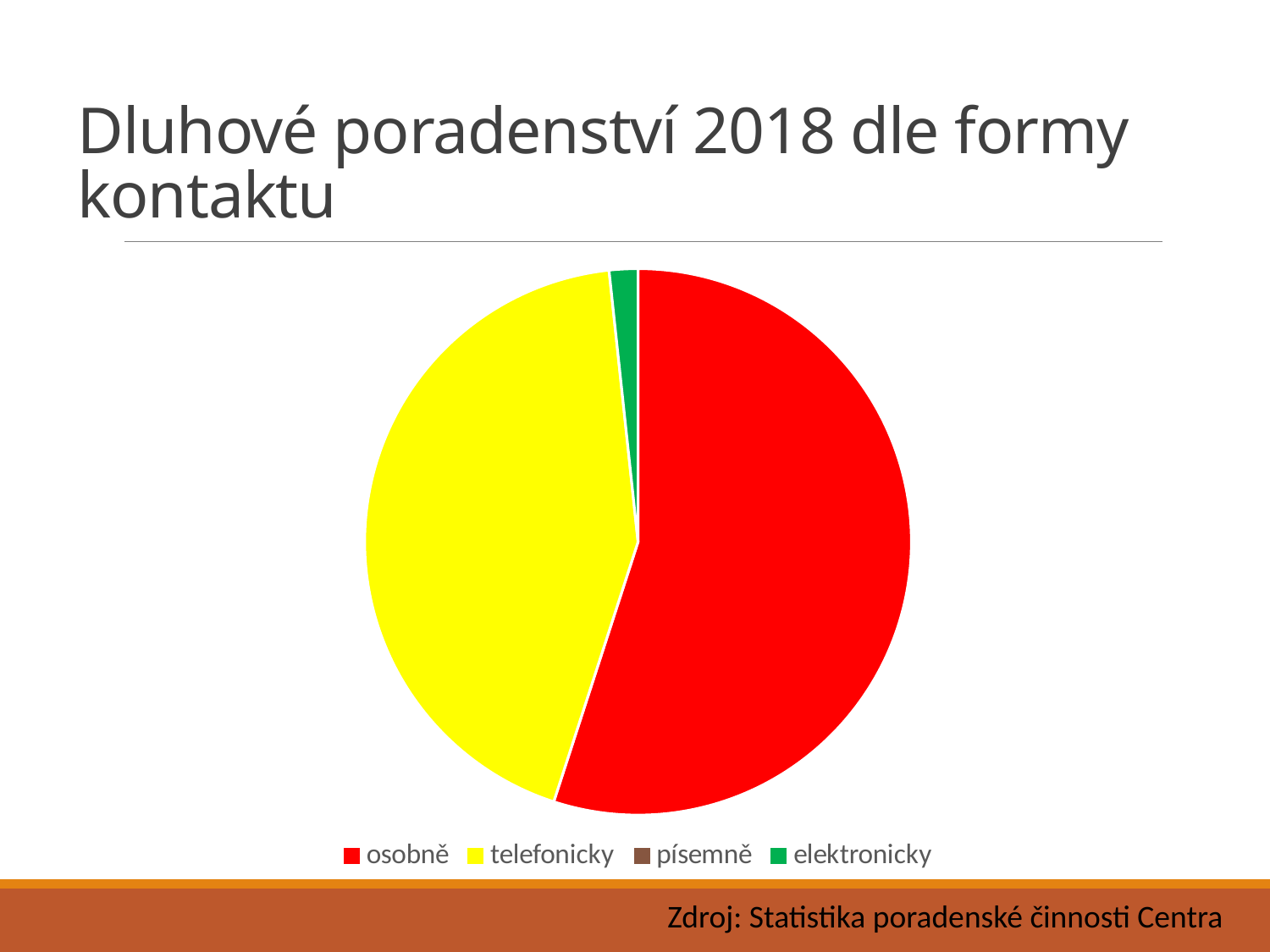
Which form of contact has the largest slice of the pie? osobně What is the title of the slide containing the chart? Dluhové poradenství 2018 dle formy kontaktu What colour represents the category osobně in the pie chart? red Which slice is larger, osobně or elektronicky? osobně Which slice is larger, telefonicky or elektronicky? telefonicky What kind of chart is shown on the slide? pie chart Which slice is larger, osobně or telefonicky? osobně How many categories does the legend list? 4 Which category is shown in yellow? telefonicky